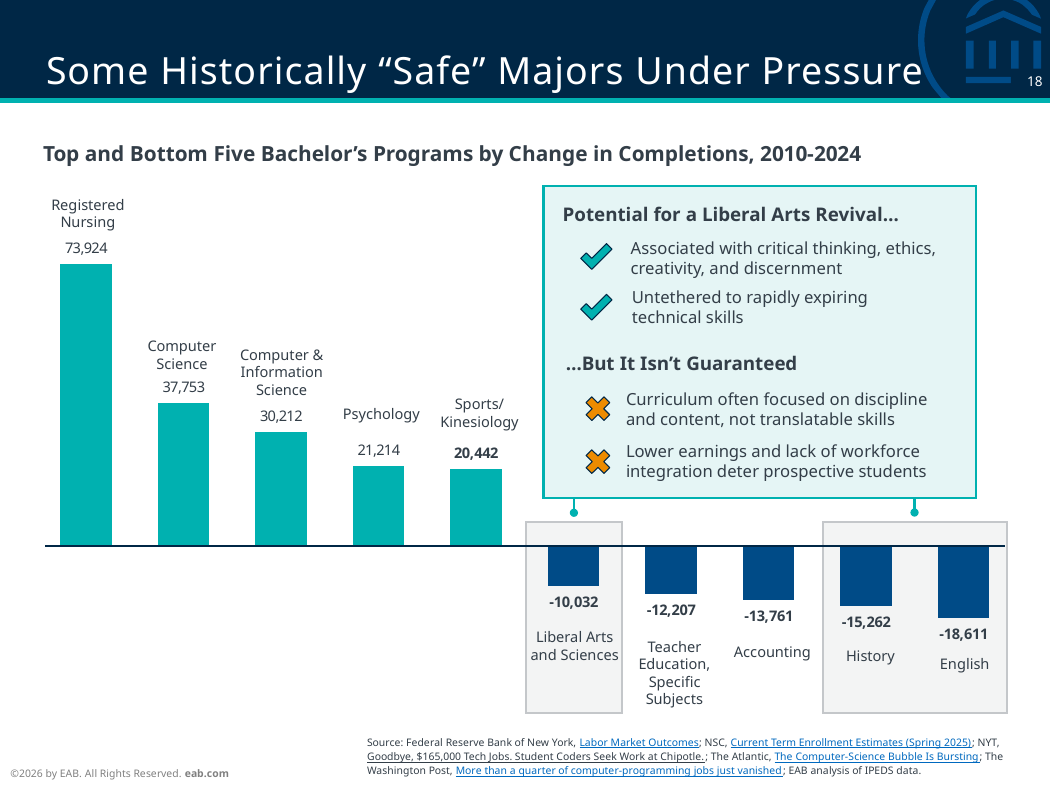
What is the title of the chart? Top and Bottom Five Bachelor's Programs by Change in Completions, 2010-2024 What is the value shown for Accounting? -13,761 What is the difference between the values for Registered Nursing and Computer Science? 36,171 Which has a larger change in completions, Psychology or Computer & Information Science? Computer & Information Science Which program has the highest change in completions? Registered Nursing What is the change in completions for English? -18,611 How many programs are shown in the chart? 10 What kind of chart is shown on the slide? Bar chart What is the value shown for Sports/Kinesiology? 20,442 Which program has the lowest change in completions? English What is the difference between the values for History and English? 3,349 What is the change in completions for Registered Nursing? 73,924